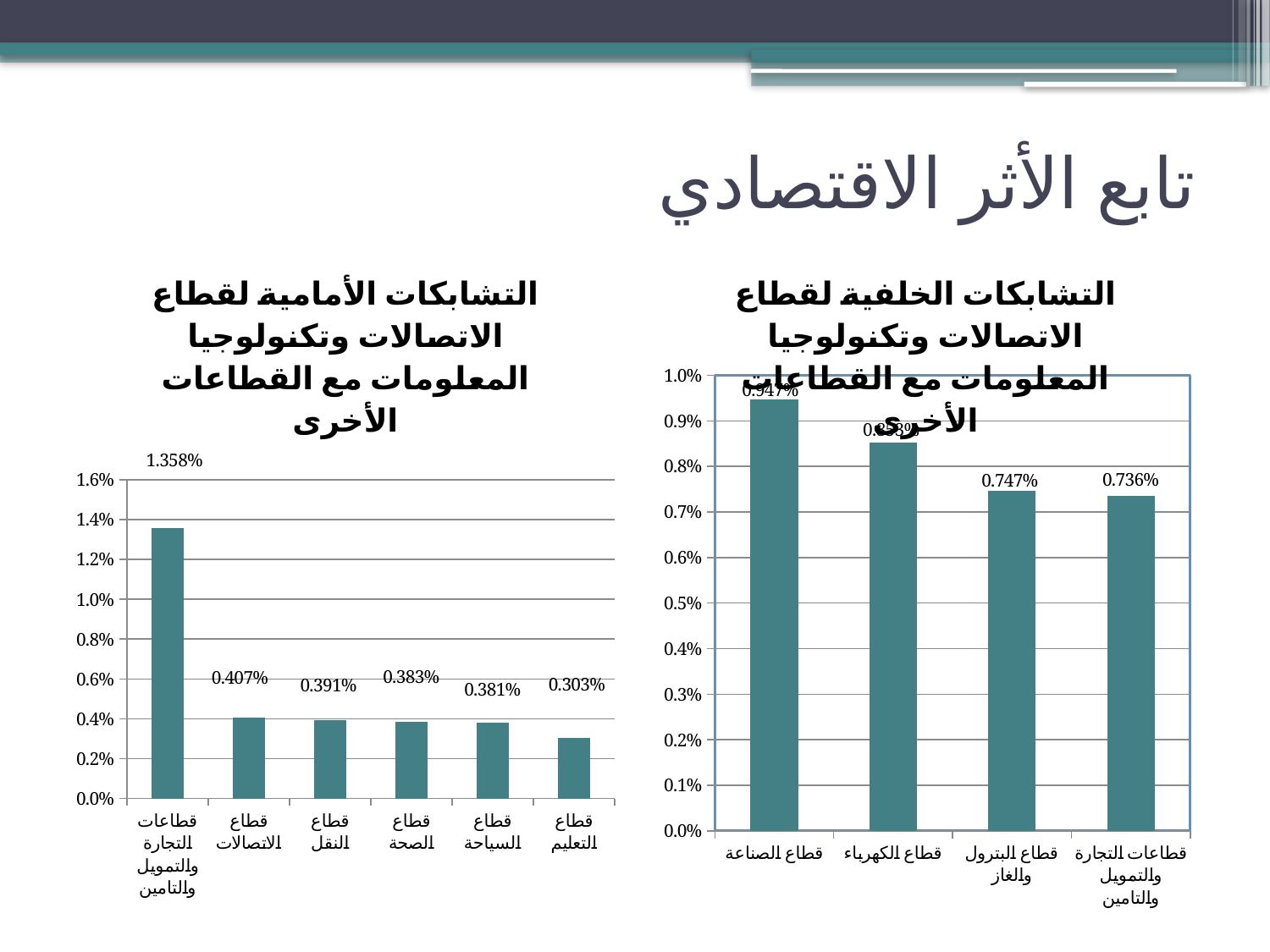
In the right-hand chart (التشابكات الخلفية), how many categories are plotted? 4 In the left-hand chart (التشابكات الأمامية), which category has the lowest value? قطاع التعليم In the left-hand chart (التشابكات الأمامية), what is the value for قطاعات التجارة والتمويل والتأمين? 1.358% In the right-hand chart (التشابكات الخلفية), which category has the highest value? قطاع الصناعة In the right-hand chart (التشابكات الخلفية), which category has the lowest value? قطاعات التجارة والتمويل والتأمين In the right-hand chart (التشابكات الخلفية), what is the value for قطاع الصناعة? 0.947% In the left-hand chart (التشابكات الأمامية), what is the value for قطاع التعليم? 0.303% What type of chart is the left-hand chart (التشابكات الأمامية)? bar chart In the left-hand chart (التشابكات الأمامية), is the value for قطاع الاتصالات greater or less than 0.6%? less In the left-hand chart (التشابكات الأمامية), how many categories are plotted? 6 In the right-hand chart (التشابكات الخلفية), what is the value for قطاع البترول والغاز? 0.747% In the right-hand chart (التشابكات الخلفية), what is the difference between the values for قطاع الصناعة and قطاع البترول والغاز? 0.200%